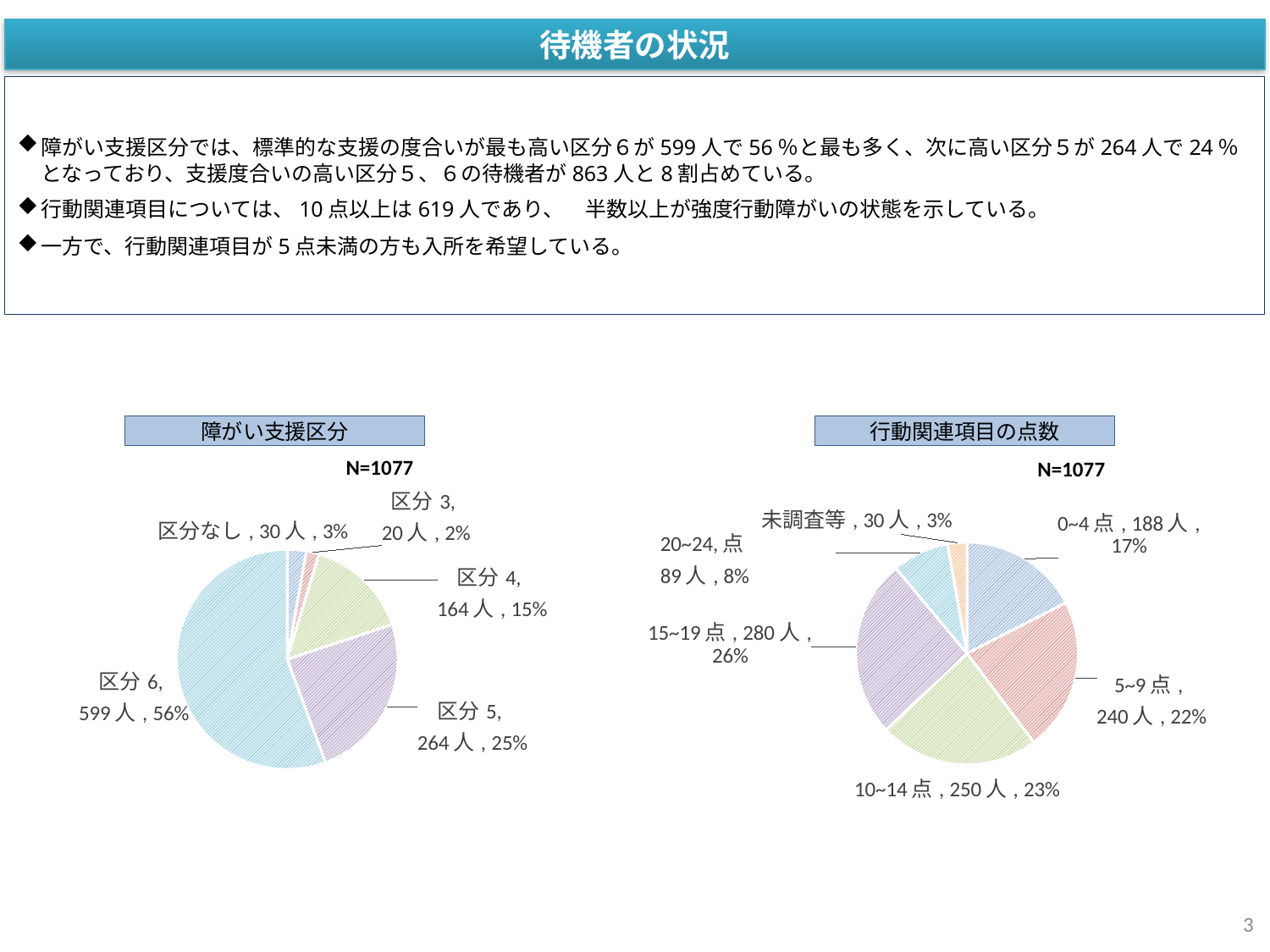
「障がい支援区分」の円グラフで、区分4の割合は何%ですか？ 15% 「障がい支援区分」の円グラフで、最も人数が少ない区分はどれですか？ 区分3 「障がい支援区分」の円グラフで、区分6の人数は何人ですか？ 599人 「行動関連項目の点数」の円グラフで、5~9点と0~4点ではどちらの人数が多いですか？ 5~9点 「障がい支援区分」の円グラフには、いくつの区分（カテゴリ）がありますか？ 5 「障がい支援区分」の円グラフで、区分5と区分6の人数の合計は何人ですか？ 863人 「障がい支援区分」の円グラフで、区分5と区分4の人数の差は何人ですか？ 100人 「行動関連項目の点数」の円グラフには、いくつのカテゴリがありますか？ 6 スライドの2つのグラフはどの種類のグラフですか？ 円グラフ 「行動関連項目の点数」の円グラフで、15~19点の人数は何人ですか？ 280人 「行動関連項目の点数」の円グラフで、最も人数が多い点数区分はどれですか？ 15~19点 「行動関連項目の点数」の円グラフで、20~24点の割合は何%ですか？ 8%